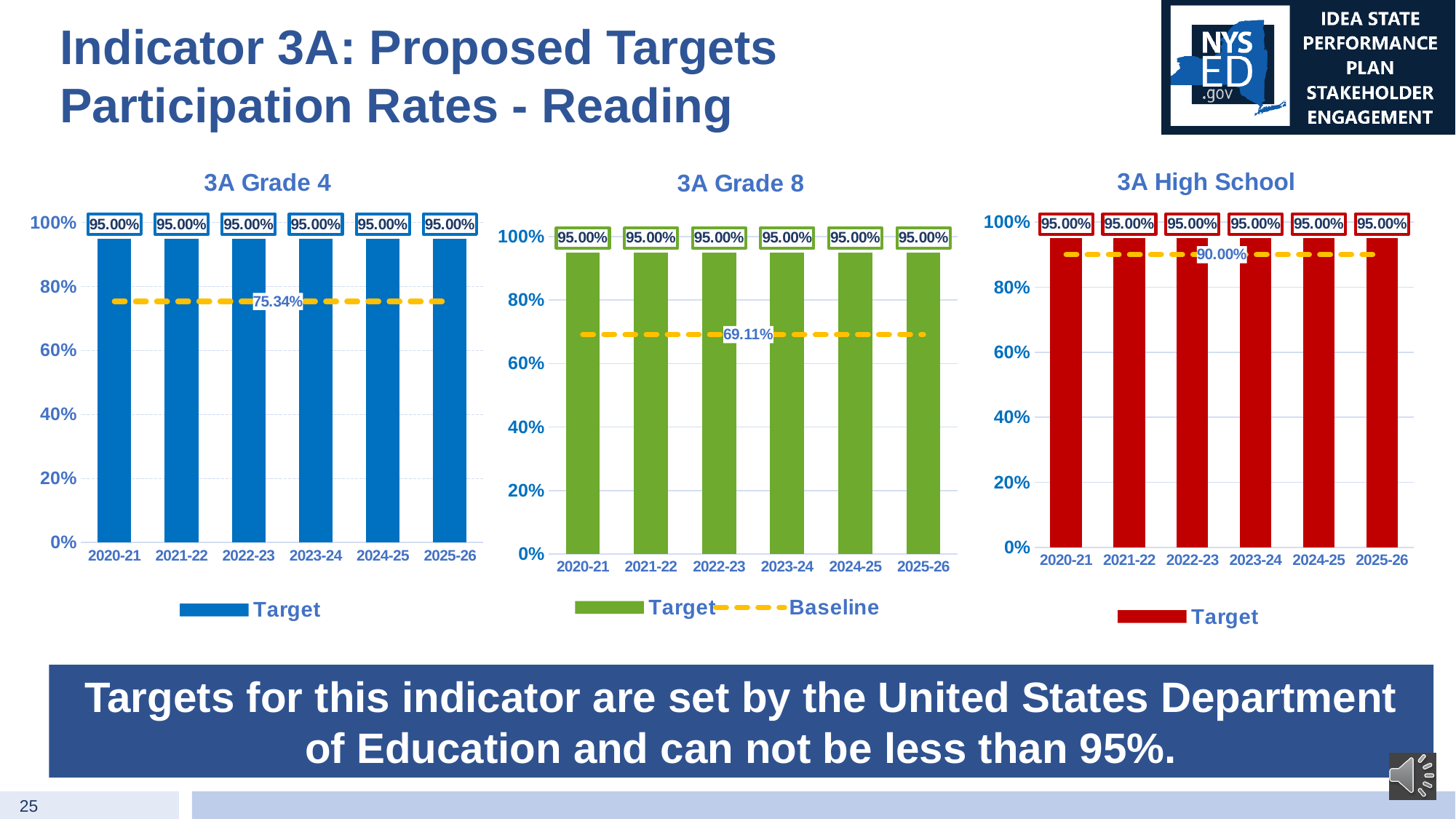
In the 3A Grade 4 chart, how many school years are shown on the x axis? 6 In the 3A Grade 4 chart, what is the Baseline value shown on the dashed line? 75.34% How many series does the legend of the 3A Grade 8 chart list? 2 In the 3A Grade 4 chart, do the Target values rise, fall, or stay the same from 2020-21 to 2025-26? stay the same In the 3A Grade 8 chart, what is the difference between the Target for 2020-21 and the Baseline? 25.89% In the 3A High School chart, what is the Baseline value shown on the dashed line? 90.00% What kind of chart is the 3A High School chart? bar chart In the 3A Grade 4 chart, what is the Target value for 2022-23? 95.00% What colour are the Target bars in the 3A Grade 8 chart? green In the 3A High School chart, what is the Target value for 2025-26? 95.00% In the 3A Grade 8 chart, is the Baseline value greater or less than 80%? less In the 3A Grade 8 chart, what is the Baseline value shown on the dashed line? 69.11%